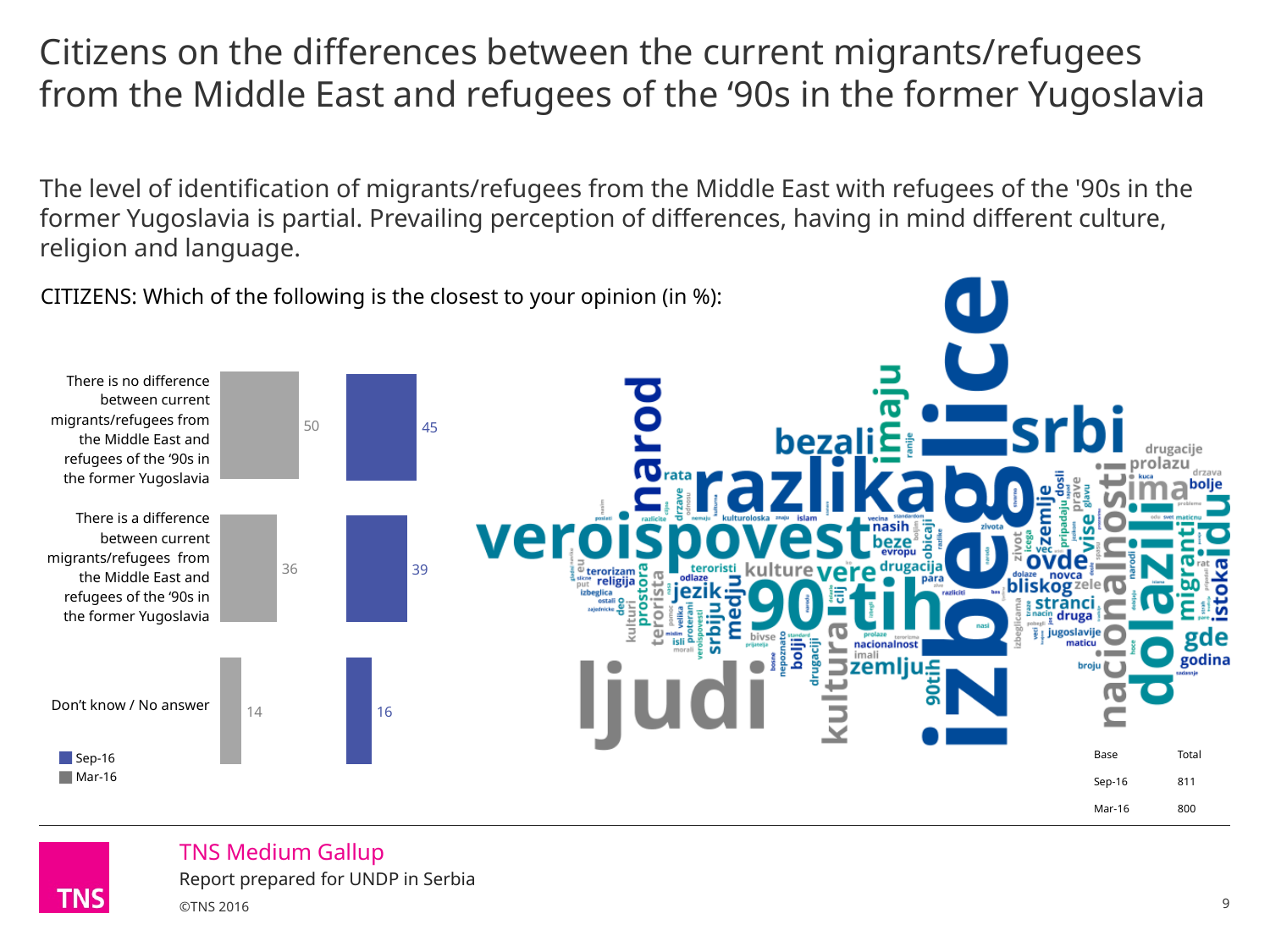
Which response category has the lowest Mar-16 value? Don't know / No answer How many series does the chart legend list? 2 What is the difference between the Mar-16 and Sep-16 values for 'There is no difference between current migrants/refugees from the Middle East and refugees of the '90s in the former Yugoslavia'? 5 What is the Sep-16 value for 'There is no difference between current migrants/refugees from the Middle East and refugees of the '90s in the former Yugoslavia'? 45 What is the Mar-16 value for 'Don't know / No answer'? 14 For 'There is a difference between current migrants/refugees from the Middle East and refugees of the '90s in the former Yugoslavia', which is larger: the Sep-16 value or the Mar-16 value? Sep-16 Which response category has the highest Sep-16 value? There is no difference between current migrants/refugees from the Middle East and refugees of the '90s in the former Yugoslavia What is the Mar-16 value for 'There is no difference between current migrants/refugees from the Middle East and refugees of the '90s in the former Yugoslavia'? 50 Which colour represents the Sep-16 series in the chart? blue What is the Sep-16 value for 'There is a difference between current migrants/refugees from the Middle East and refugees of the '90s in the former Yugoslavia'? 39 How many response categories are shown in the chart? 3 What kind of chart is shown on the slide? bar chart